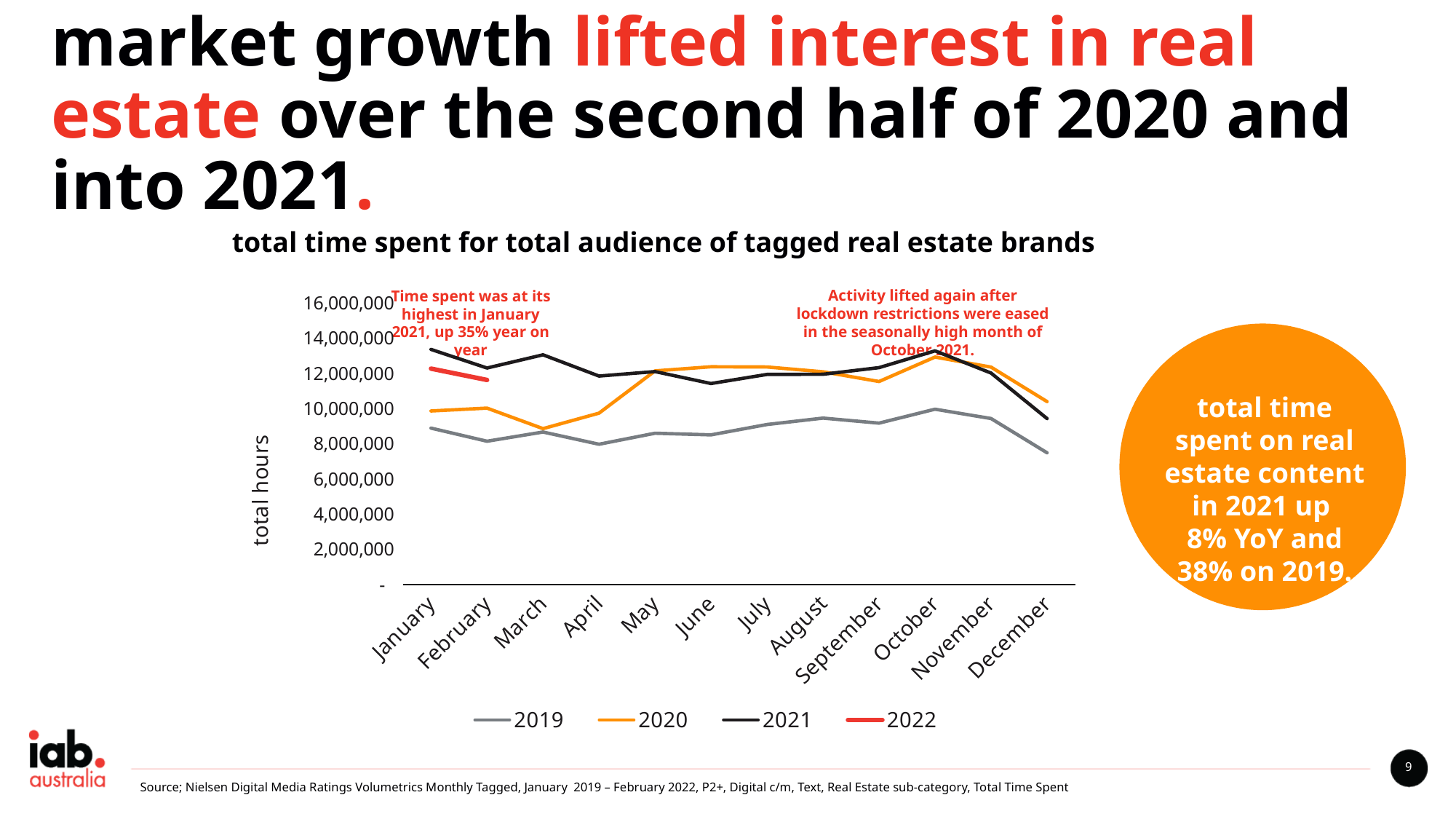
How many series does the chart's legend list? 4 In January, which series has the larger value, 2019 or 2021? 2021 Does the 2022 series rise or fall from January to February? fall What kind of chart is shown on the slide? line chart What is the label on the chart's vertical axis? total hours Is the value for January in the 2021 series greater or less than 12,000,000? greater Is the value for March in the 2020 series greater or less than 10,000,000? less In which month is the 2019 series at its lowest? December What is the title of the chart? total time spent for total audience of tagged real estate brands How many months are shown along the x axis of the chart? 12 Is the value for December in the 2019 series greater or less than 8,000,000? less